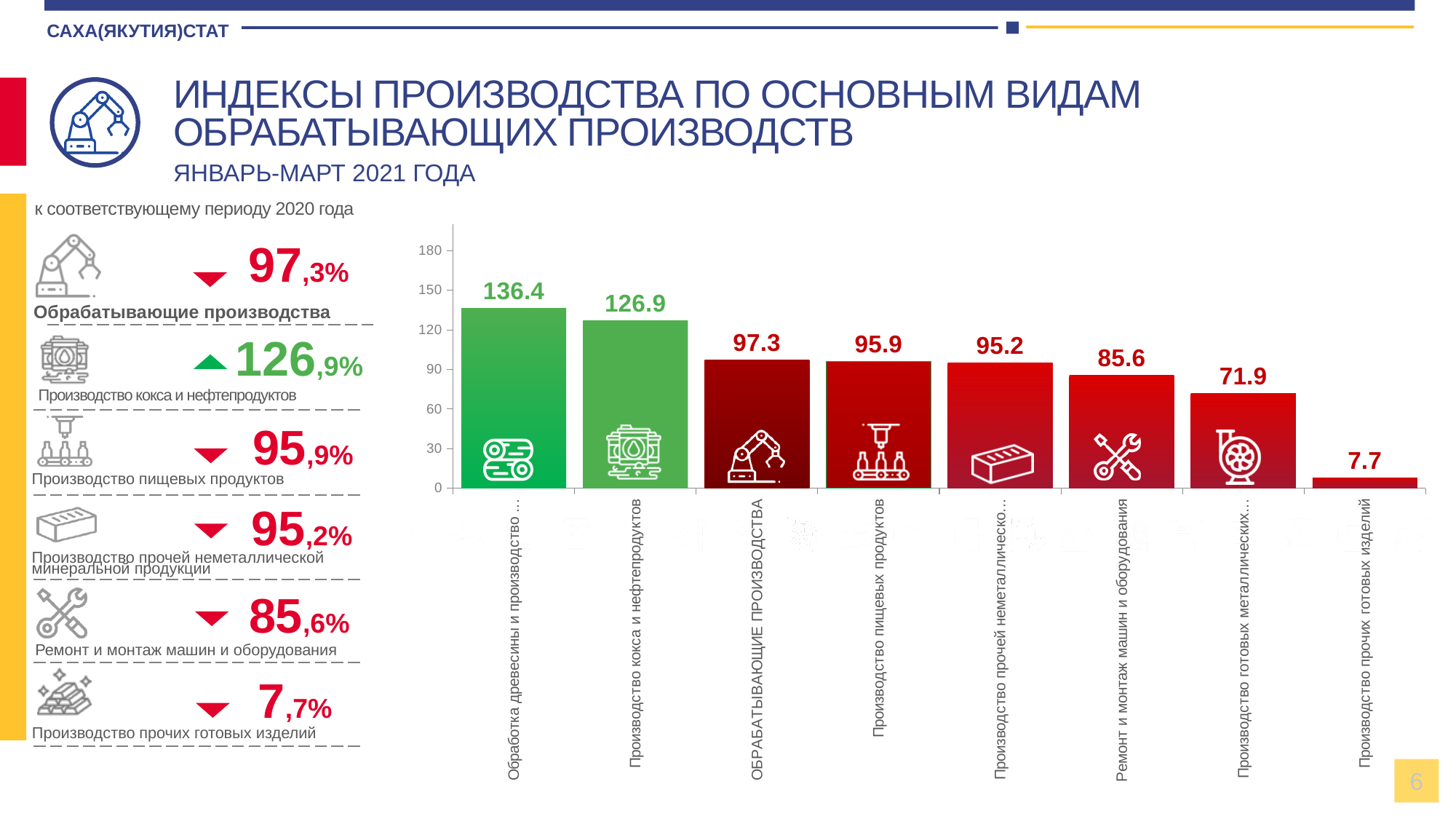
Which is larger: the value for Производство пищевых продуктов or the value for Ремонт и монтаж машин и оборудования? Производство пищевых продуктов What is the value for ОБРАБАТЫВАЮЩИЕ ПРОИЗВОДСТВА in the chart? 97.3 How many bars are plotted in the chart? 8 Which category has the lowest value in the chart? Производство прочих готовых изделий Which category has the highest value in the chart? Обработка древесины и производство ... Do the bar values rise or fall from left to right along the x axis? fall What is the difference between the values for Производство кокса и нефтепродуктов and Ремонт и монтаж машин и оборудования? 41.3 What is the value for Производство кокса и нефтепродуктов in the chart? 126.9 What is the value for Производство пищевых продуктов in the chart? 95.9 What is the value for Ремонт и монтаж машин и оборудования in the chart? 85.6 What type of chart is shown on the slide? bar chart What is the value for Производство прочих готовых изделий in the chart? 7.7